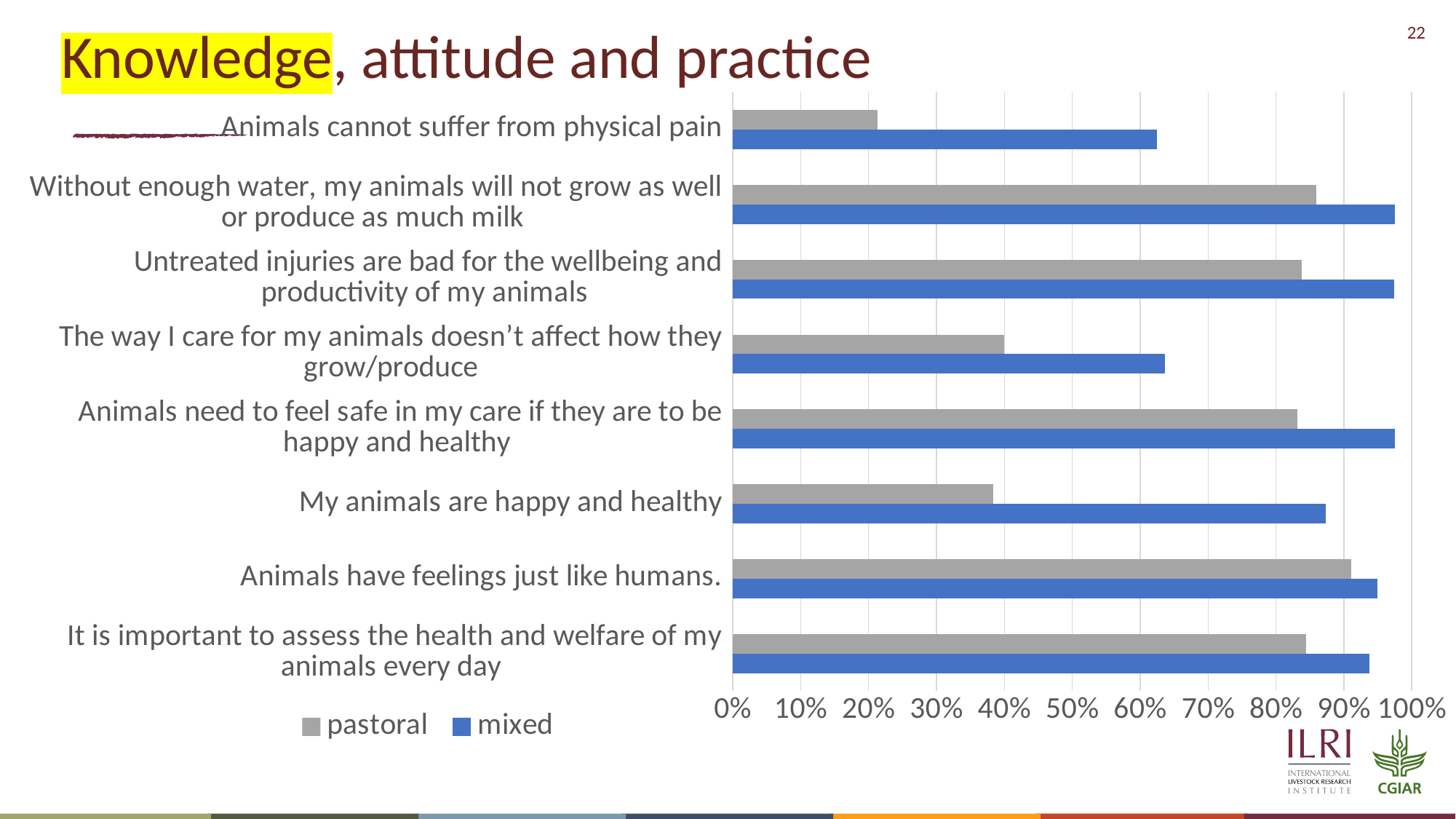
Which statement has the highest pastoral value? Animals have feelings just like humans. For "Animals need to feel safe in my care if they are to be happy and healthy", which group has the larger value, pastoral or mixed? mixed Which colour represents the pastoral series in the chart? grey How many statements (categories) are plotted on the chart? 8 Is the pastoral value for "Animals cannot suffer from physical pain" greater or less than 30%? less For "My animals are happy and healthy", which group has the larger value, pastoral or mixed? mixed How many series does the legend list? 2 Is the mixed value for "The way I care for my animals doesn't affect how they grow/produce" greater or less than 50%? greater Is the pastoral value for "My animals are happy and healthy" greater or less than 50%? less What kind of chart is shown on the slide? bar chart Which statement has the lowest pastoral value? Animals cannot suffer from physical pain